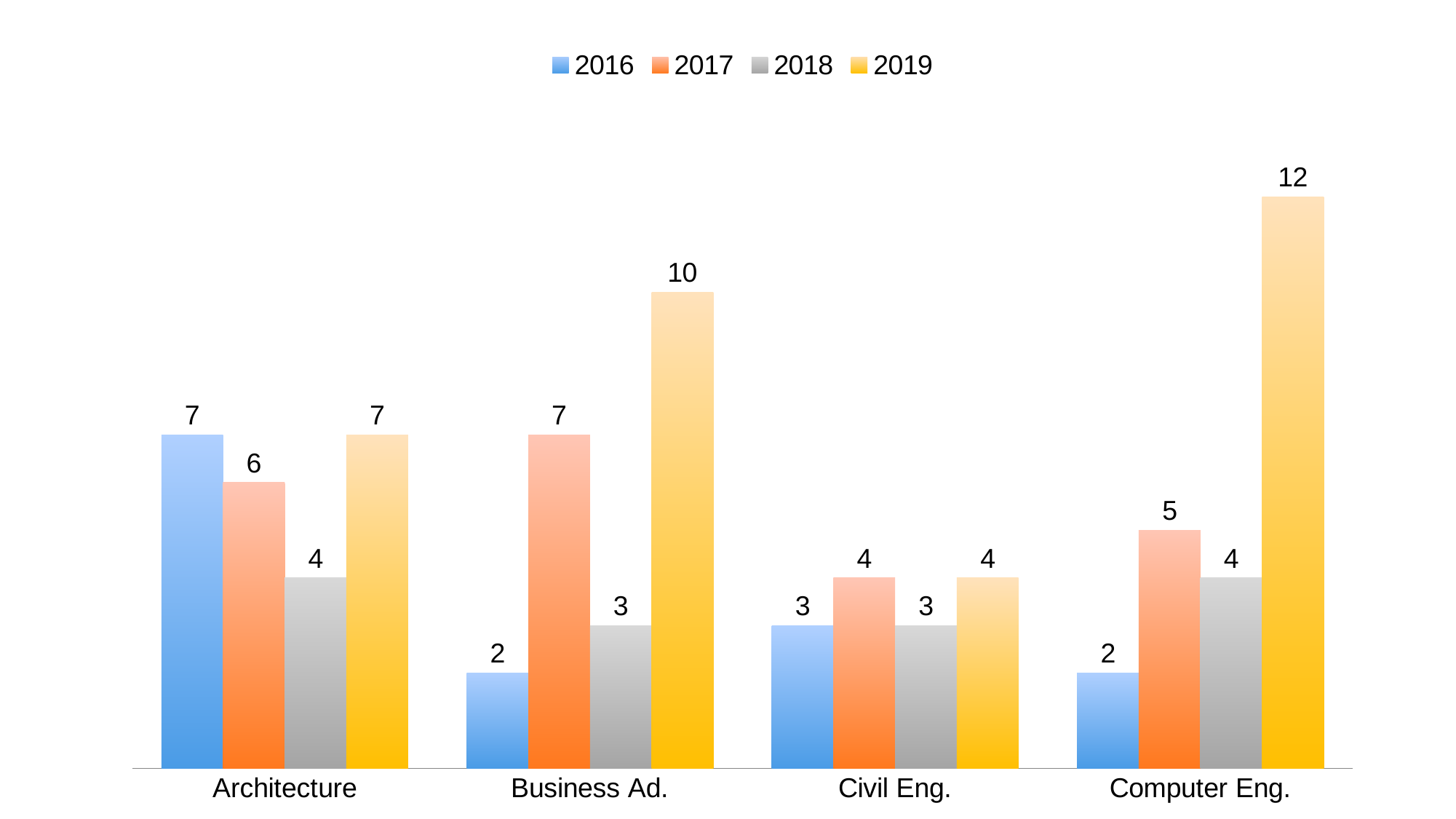
How many series does the legend list? 4 What is the value for Architecture in 2017? 6 Which category has the lowest value in 2017? Civil Eng. Which series is shown in grey in the legend? 2018 Which is larger: the 2017 value for Business Ad. or the 2017 value for Computer Eng.? Business Ad. What kind of chart is shown on the slide? Bar chart What is the value for Civil Eng. in 2018? 3 What is the value for Computer Eng. in 2019? 12 What is the difference between the 2019 and 2016 values for Business Ad.? 8 Which category has the highest value in 2019? Computer Eng. What is the value for Business Ad. in 2016? 2 How many categories are shown on the x axis? 4